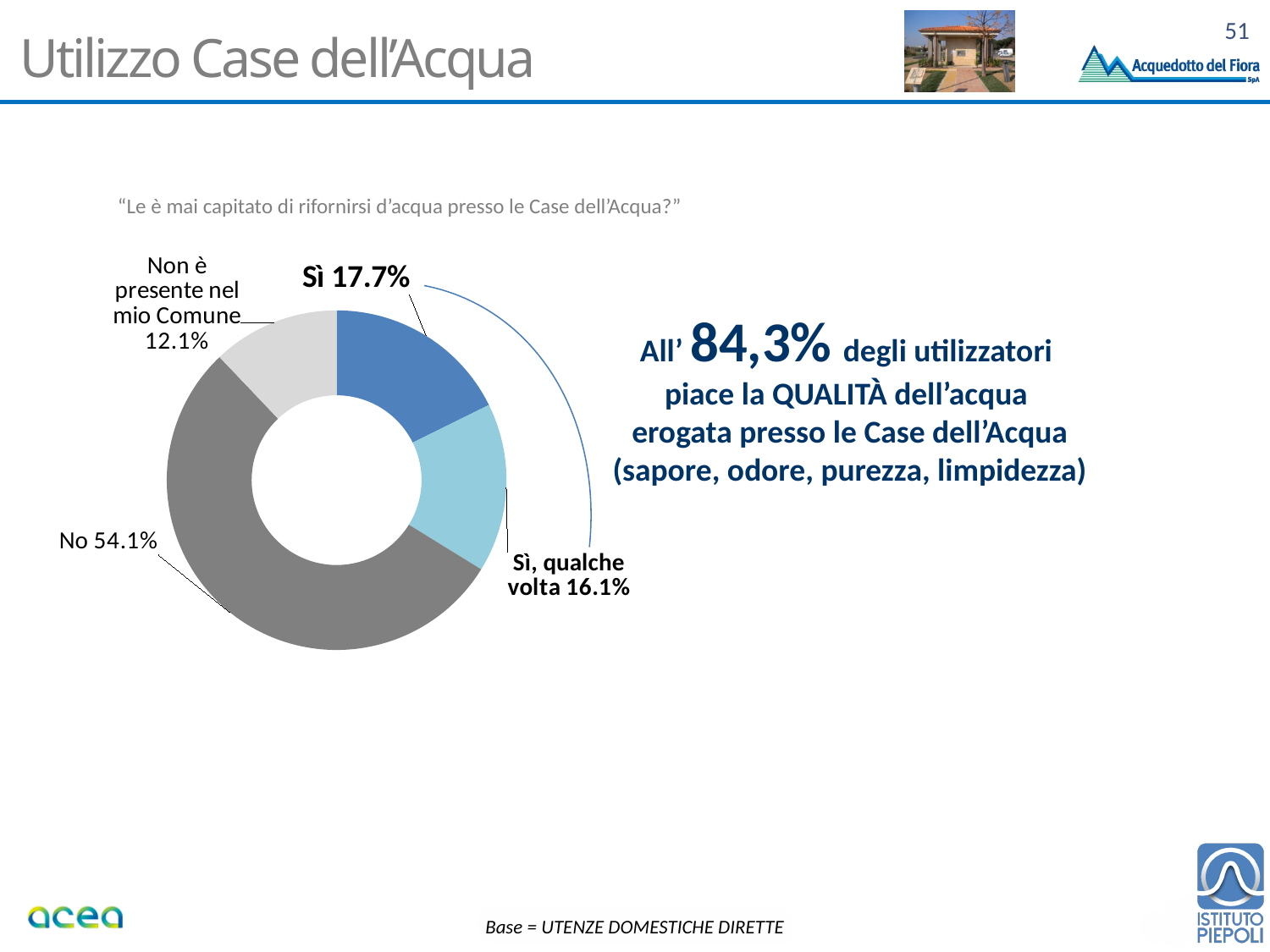
Which is larger, the share for "Sì" or the share for "Non è presente nel mio Comune"? Sì What colour is the "No" segment of the chart? Grey What percentage of respondents answered "Sì, qualche volta"? 16.1% Which response has the largest share of the chart? No What percentage of respondents answered "No"? 54.1% What is the difference in percentage points between "No" and "Sì"? 36.4 What percentage of respondents answered "Non è presente nel mio Comune"? 12.1% What kind of chart is shown on the slide? Doughnut chart Which response has the smallest share of the chart? Non è presente nel mio Comune How many response categories are shown in the chart? 4 What percentage of respondents answered "Sì"? 17.7% What is the difference in percentage points between "Sì" and "Sì, qualche volta"? 1.6